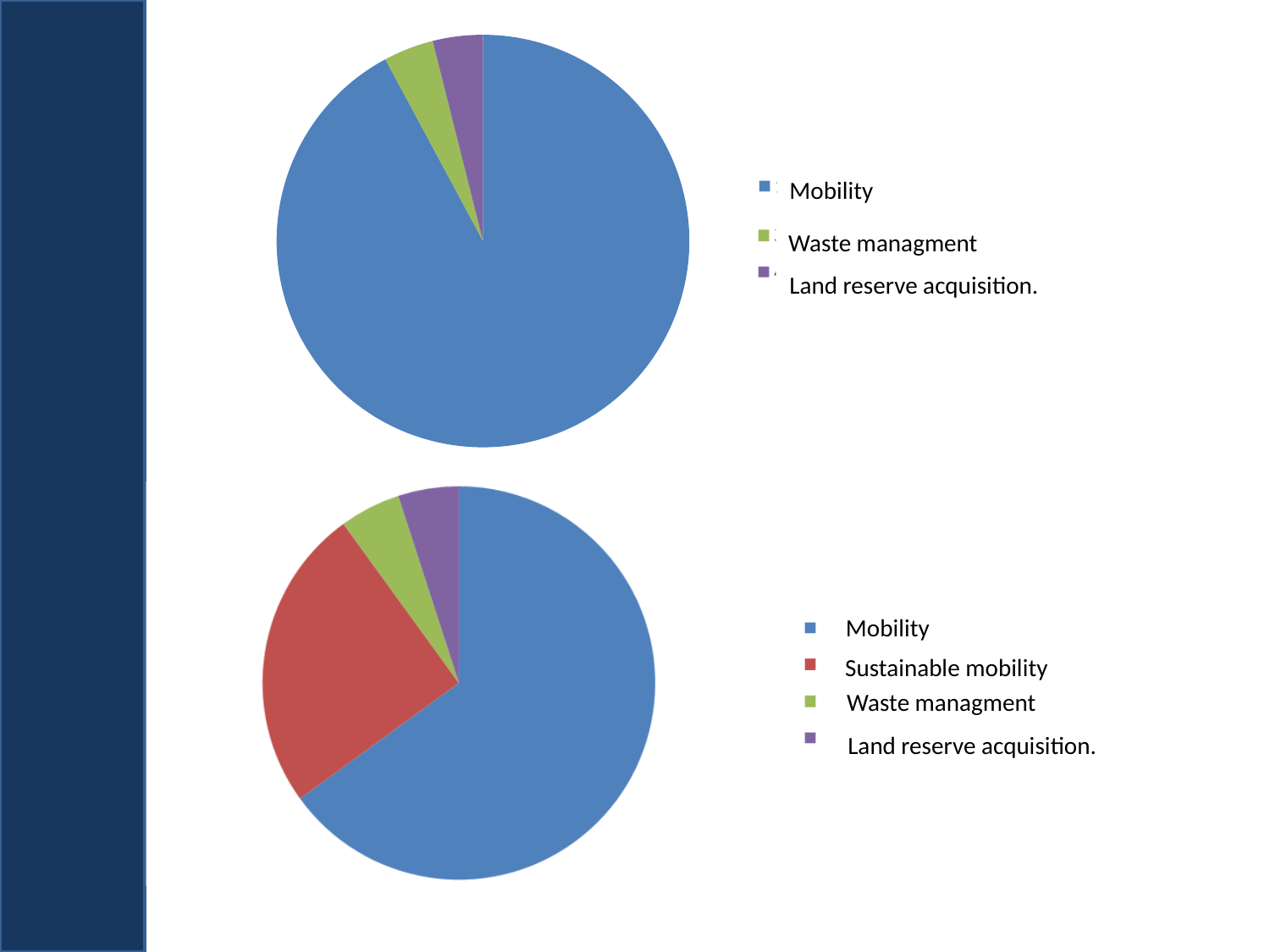
What kind of chart is the top chart on the slide? pie chart What kind of chart is the bottom chart on the slide? pie chart In the top pie chart, which category has the largest slice? Mobility In the bottom pie chart, which category has the largest slice? Mobility In the top pie chart, how many categories does the legend list? 3 In the bottom pie chart, how many categories does the legend list? 4 In the bottom pie chart, what colour is the Sustainable mobility slice? red In the top pie chart, which is larger, the Mobility slice or the Waste managment slice? Mobility In the bottom pie chart, which is larger, the Mobility slice or the Sustainable mobility slice? Mobility In the bottom pie chart, which is larger, the Sustainable mobility slice or the Waste managment slice? Sustainable mobility Which category appears in the legend of the bottom pie chart but not in the legend of the top pie chart? Sustainable mobility